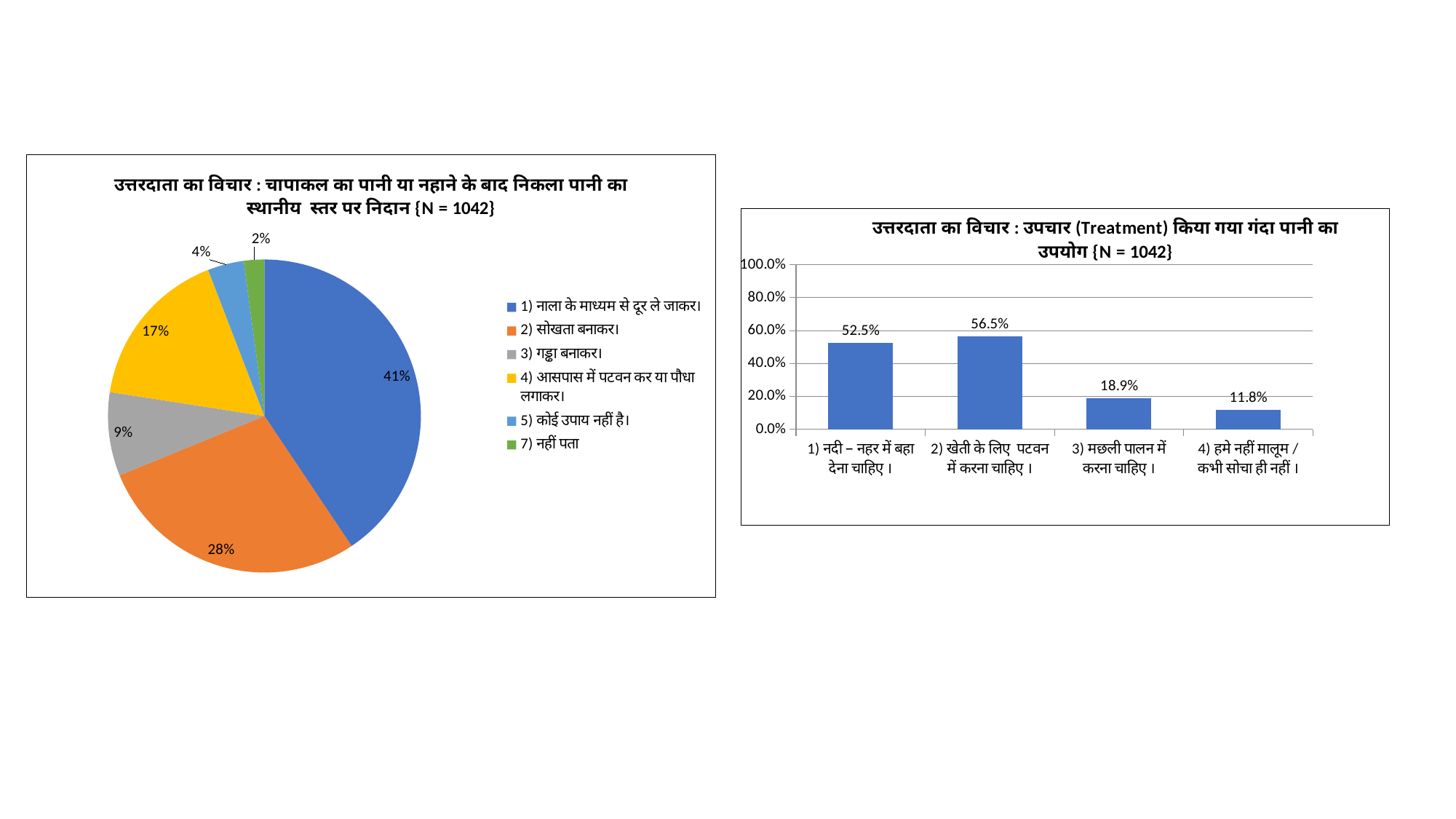
In the bar chart on the right, which category has the lowest value? 4) हमे नहीं मालूम / कभी सोचा ही नहीं In the pie chart on the left, what is the difference between the shares for "4) आसपास में पटवन कर या पौधा लगाकर" and "3) गड्ढा बनाकर"? 8% In the pie chart on the left, which category has the smallest slice? 7) नहीं पता In the pie chart on the left, what share is shown for "1) नाला के माध्यम से दूर ले जाकर"? 41% What kind of chart is the chart on the right of the slide? bar chart In the bar chart on the right, what is the value for "2) खेती के लिए पटवन में करना चाहिए"? 56.5% In the bar chart on the right, which is larger: the value for "3) मछली पालन में करना चाहिए" or "4) हमे नहीं मालूम / कभी सोचा ही नहीं"? 3) मछली पालन में करना चाहिए In the bar chart on the right, what is the difference between the values for "2) खेती के लिए पटवन में करना चाहिए" and "1) नदी – नहर में बहा देना चाहिए"? 4.0% In the pie chart on the left, what share is shown for "2) सोखता बनाकर"? 28% In the pie chart on the left, how many categories does the legend list? 6 What kind of chart is the chart on the left of the slide? pie chart In the bar chart on the right, how many bars are plotted? 4